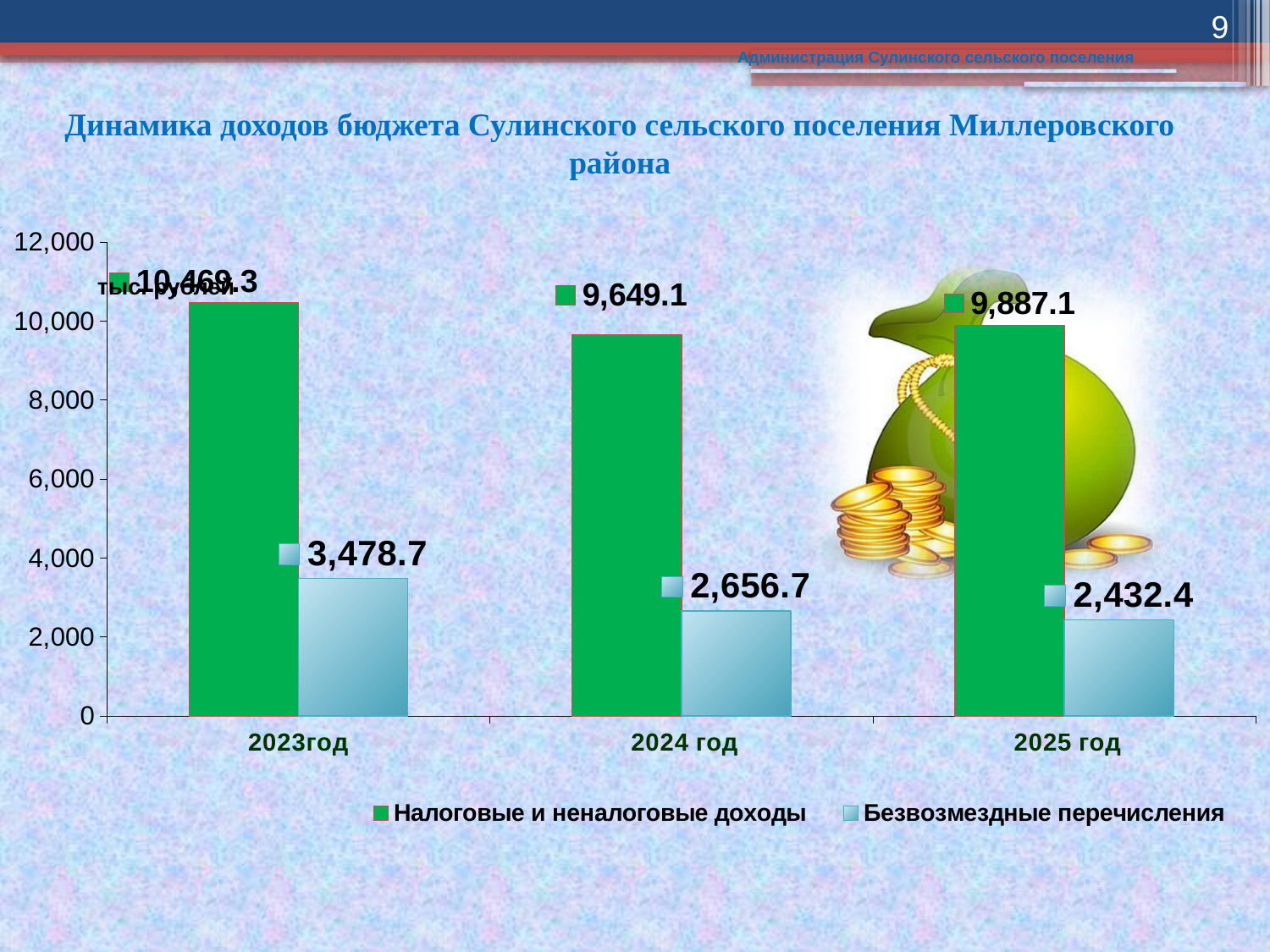
Which year has the larger value for Налоговые и неналоговые доходы, 2024 год or 2025 год? 2025 год Is the value of Налоговые и неналоговые доходы for 2023год greater or less than 10,000? greater In which year is Безвозмездные перечисления the lowest? 2025 год What is the difference between Налоговые и неналоговые доходы and Безвозмездные перечисления in 2024 год? 6,992.4 What is the value of Налоговые и неналоговые доходы for 2025 год? 9,887.1 What is the value of Налоговые и неналоговые доходы for 2024 год? 9,649.1 What is the value of Безвозмездные перечисления for 2023год? 3,478.7 In which year is Безвозмездные перечисления the highest? 2023год Do the values for Безвозмездные перечисления rise or fall from 2023год to 2025 год? fall What is the value of Безвозмездные перечисления for 2024 год? 2,656.7 What is the value of Безвозмездные перечисления for 2025 год? 2,432.4 How many series does the legend list? 2